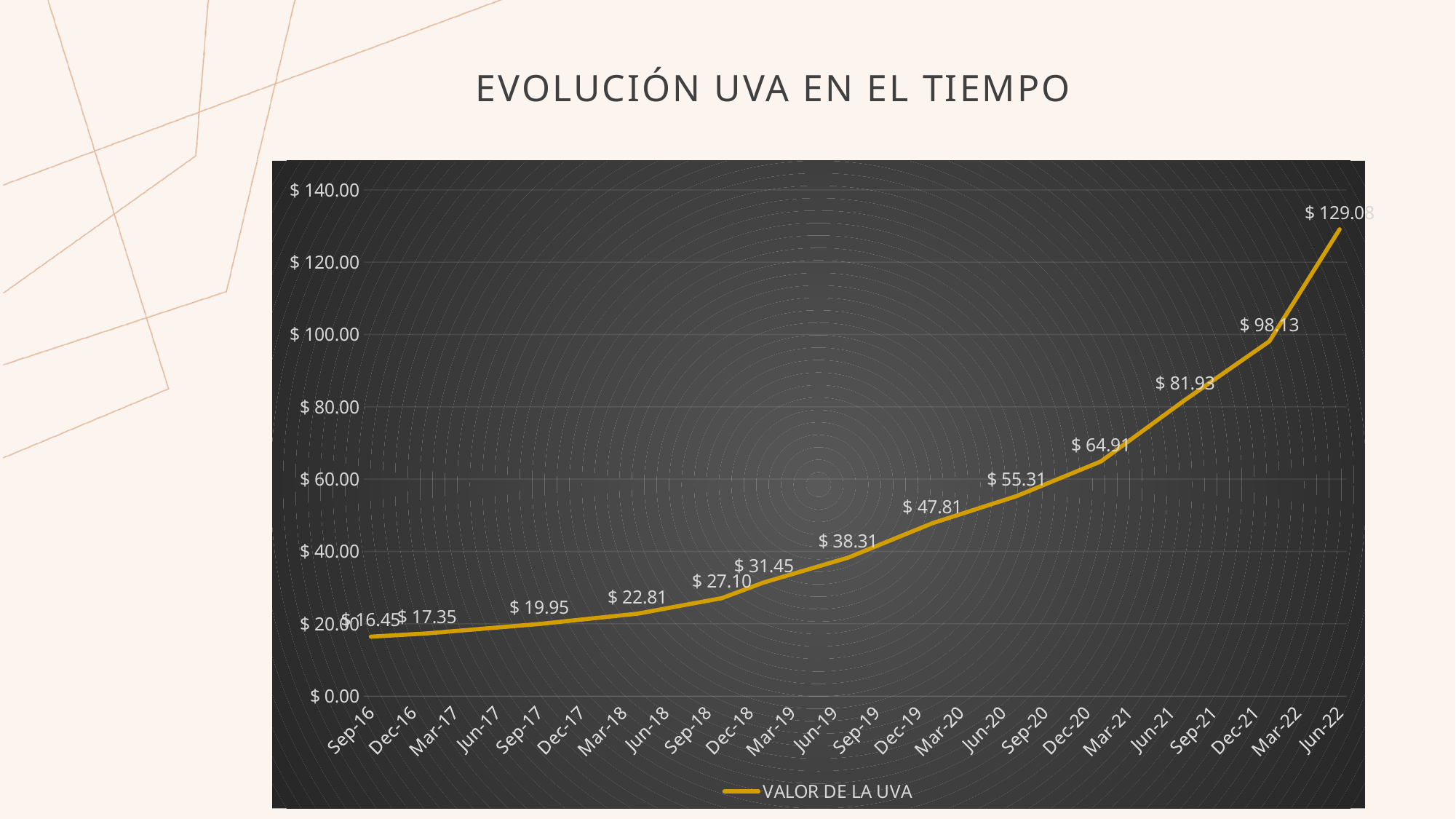
Is the value for Dec-19 greater or less than $ 60.00? less What kind of chart is shown on the slide? line chart At which date is the value of the UVA highest? Jun-22 What is the difference between the UVA value at Jun-22 and at Sep-16? $ 112.63 What is the title of the chart? EVOLUCIÓN UVA EN EL TIEMPO How many series does the legend list? 1 What is the name of the series shown in the legend? VALOR DE LA UVA At which date is the value of the UVA lowest? Sep-16 Does the value of the UVA rise or fall from Sep-16 to Jun-22? rises What is the value of the UVA at Sep-16? $ 16.45 How many dates are labelled on the x axis? 24 What is the value of the UVA at Jun-22? $ 129.08